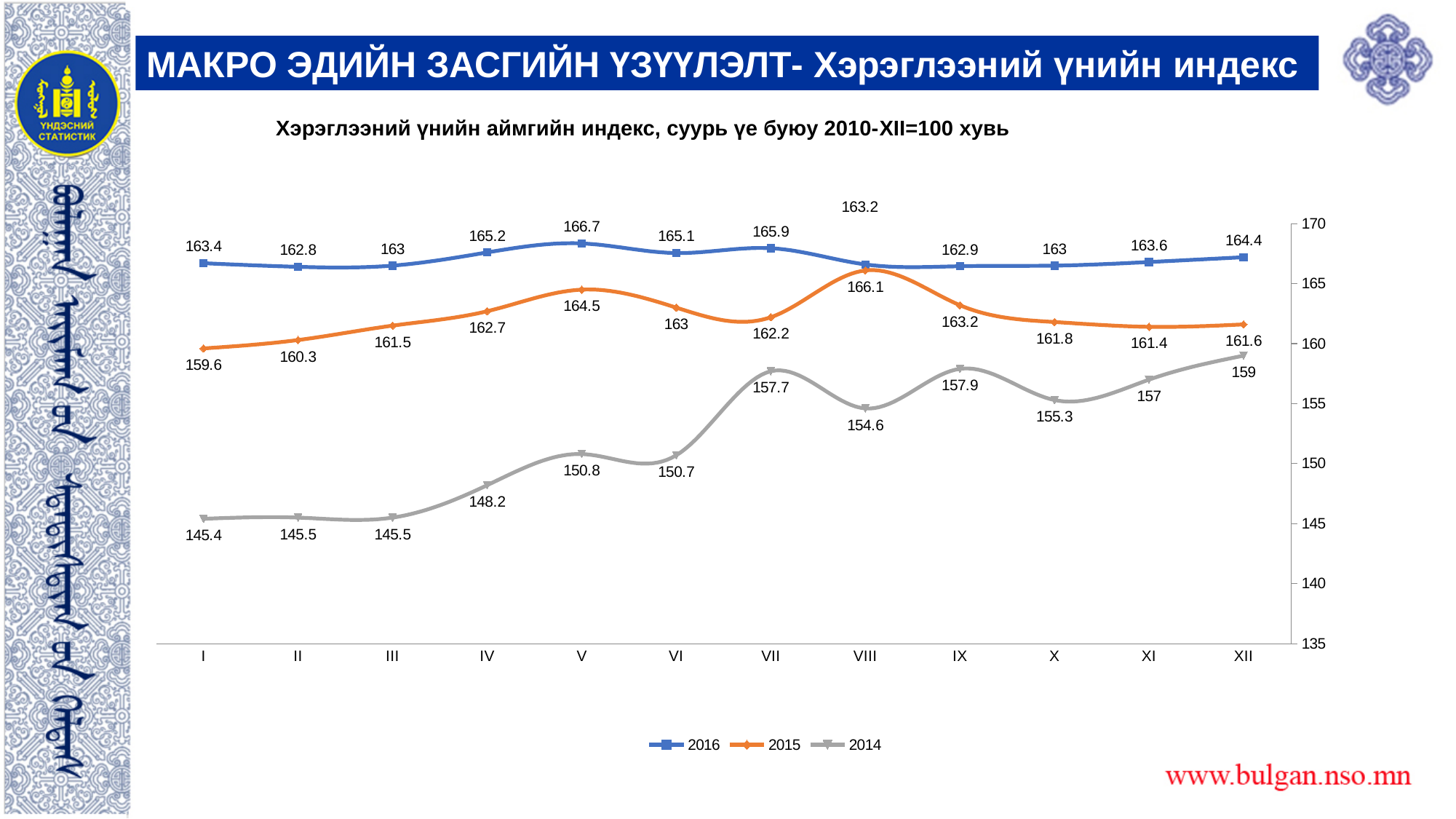
Which series is drawn in orange in the legend? 2015 How many series does the legend list? 3 What is the value for 2014 in month I? 145.4 In which month is the 2014 series highest? XII In which month is the 2015 series lowest? I What is the value for 2015 in month VIII? 166.1 What is the value for 2016 in month V? 166.7 What is the difference between the 2016 and 2014 values in month XII? 5.4 How many months (points) are plotted along the x axis? 12 Which is larger in month VIII: the 2016 value or the 2015 value? 2015 What type of chart is shown on the slide? line chart Does the 2014 series generally rise or fall from month I to month XII? rise